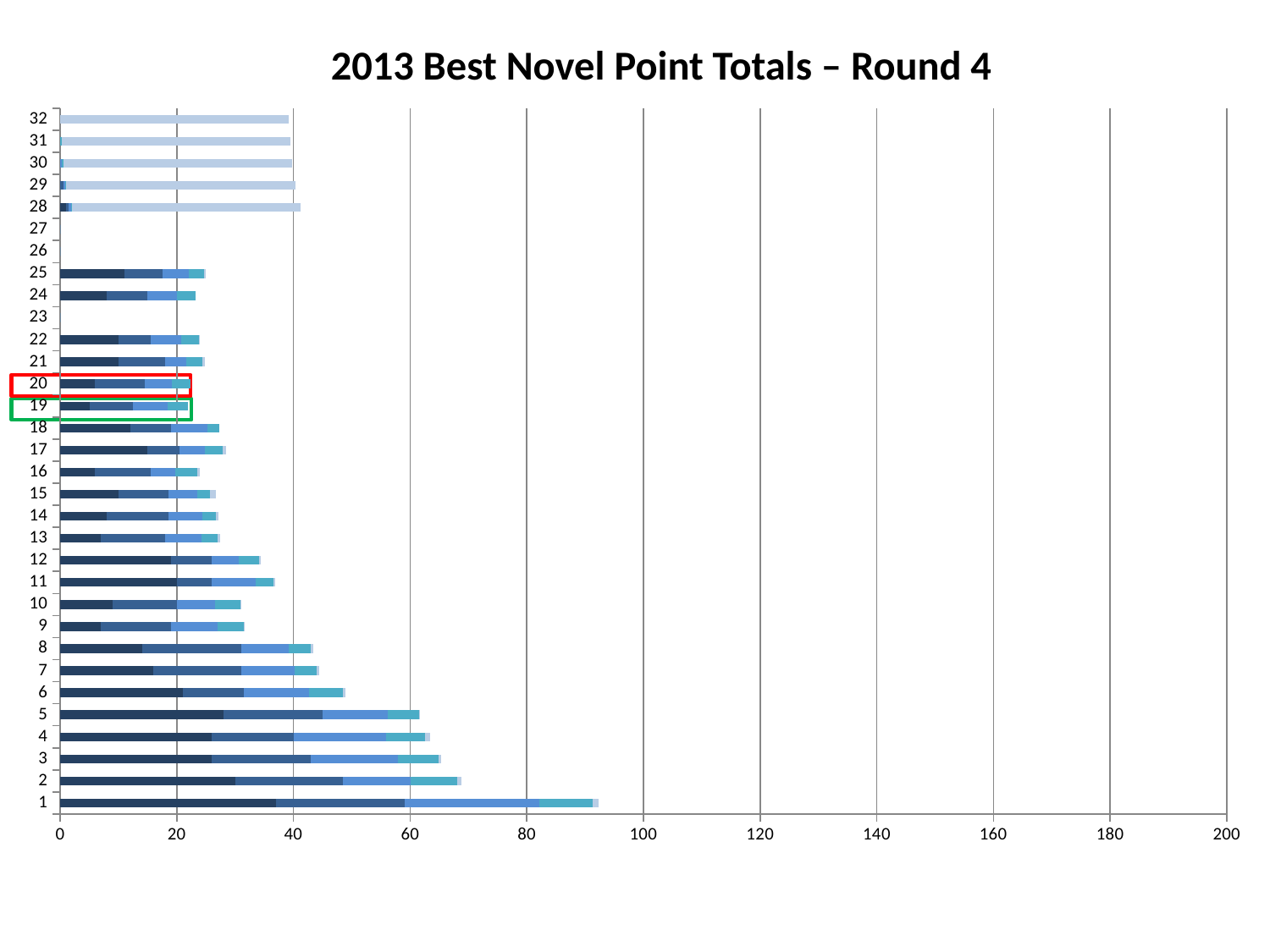
Is the total value for category 12 greater or less than 40? less Is the total value for category 6 greater or less than 60? less Is the total value for category 2 greater or less than 60? greater What is the title of the chart? 2013 Best Novel Point Totals – Round 4 What kind of chart is shown on the slide? Bar chart Which has the larger total, category 11 or category 16? 11 How many categories are listed on the vertical axis of the chart? 32 Which has the larger total, category 8 or category 9? 8 Which category label is outlined with a red box? 20 Which categories on the vertical axis have no visible bar? 23, 26 and 27 Which category has the longest bar in the chart? 1